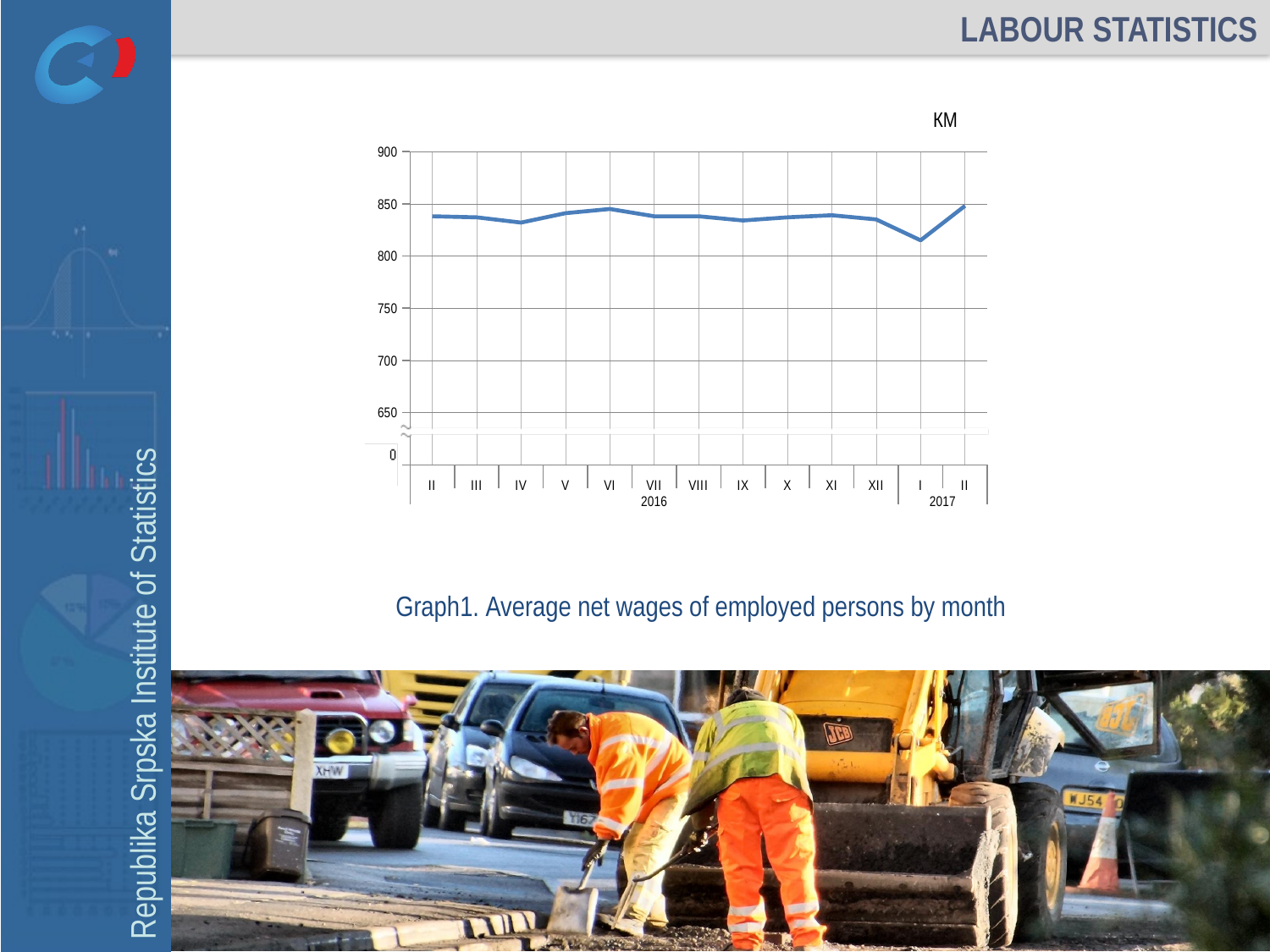
Is the value for VI 2016 greater or less than 800? greater Does the line rise or fall from XII 2016 to I 2017? fall How many monthly data points are plotted on the chart? 13 What unit is shown above the chart's vertical axis? KM What kind of chart is shown on the slide? line chart Is the value for I 2017 greater or less than 850? less Which is larger, the value for IV 2016 or the value for VI 2016? VI 2016 Which month has the lowest average net wage on the chart? I 2017 Is the value for II 2017 greater or less than 900? less Which is larger, the value for VI 2016 or the value for I 2017? VI 2016 Does the line rise or fall from I 2017 to II 2017? rise